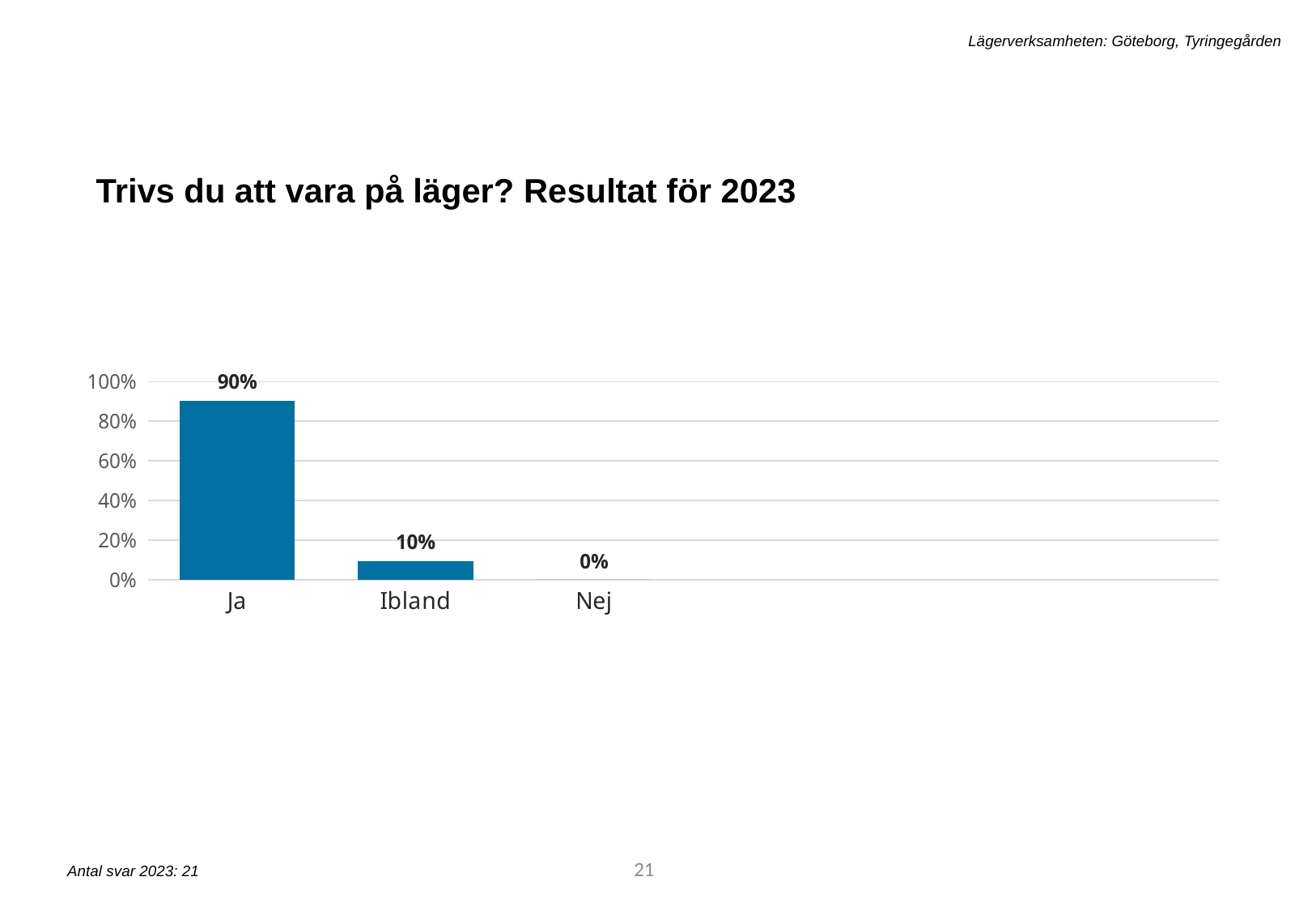
What is the title of the slide containing the chart? Trivs du att vara på läger? Resultat för 2023 What is the value for Ja? 90% What kind of chart is shown on the slide? bar chart Which is larger, the value for Ibland or the value for Nej? Ibland Which category has the highest value? Ja Which category has the lowest value? Nej Is the value for Ja greater or less than 80%? greater How many categories are shown on the x axis? 3 What is the value for Ibland? 10% Do the values rise or fall from left to right along the x axis? fall What is the difference between the values for Ja and Ibland? 80% What is the value for Nej? 0%